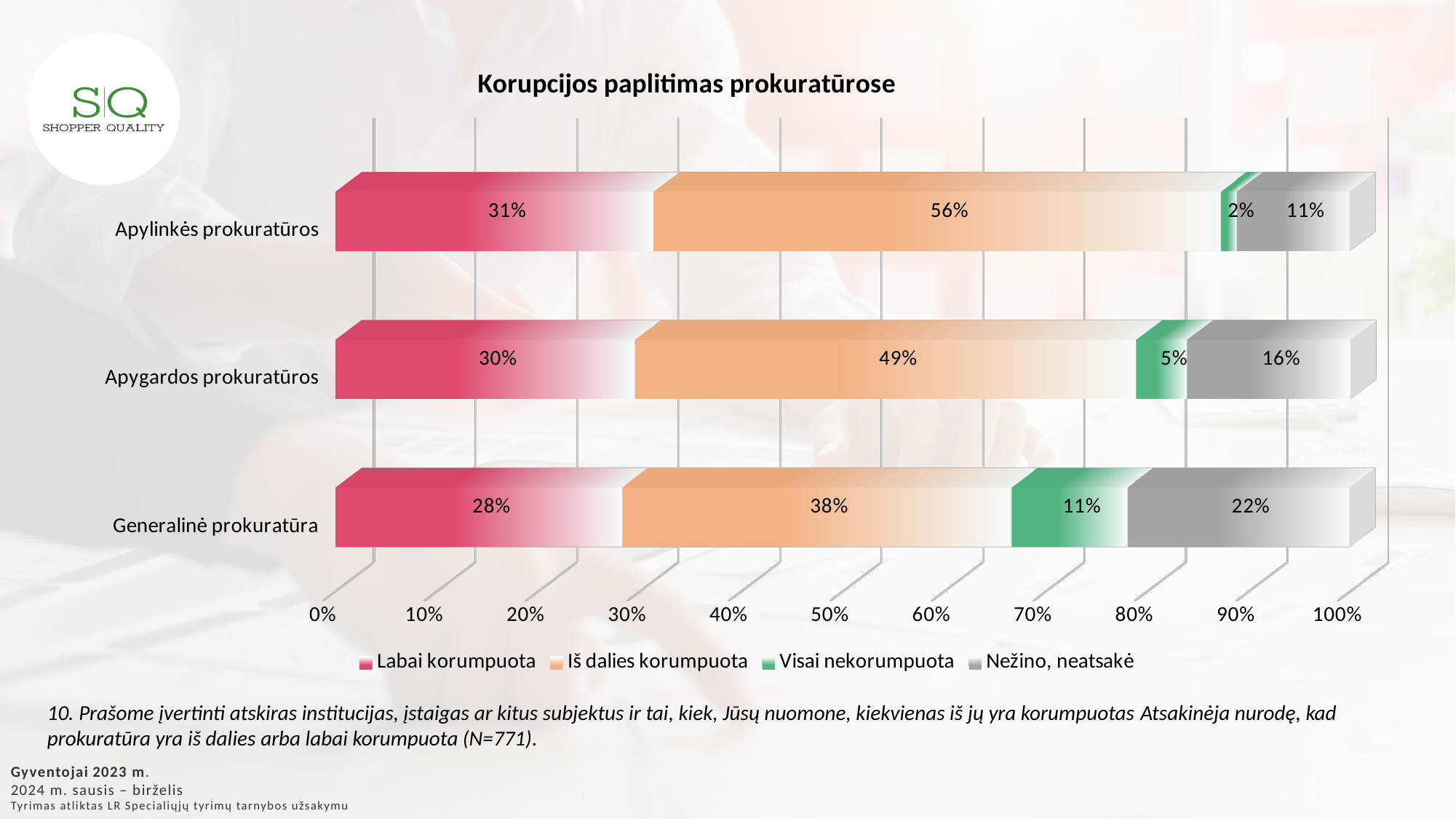
How many series does the legend list? 4 What is the 'Iš dalies korumpuota' value for Apylinkės prokuratūros? 56% How many categories (institutions) are plotted on the chart? 3 Which category has the lowest 'Visai nekorumpuota' value? Apylinkės prokuratūros Which category has the highest 'Labai korumpuota' value? Apylinkės prokuratūros What is the combined share of 'Labai korumpuota' and 'Iš dalies korumpuota' for Generalinė prokuratūra? 66% What is the 'Visai nekorumpuota' value for Apygardos prokuratūros? 5% What is the 'Nežino, neatsakė' value for Generalinė prokuratūra? 22% What kind of chart is shown on the slide? Stacked bar chart Which is larger: the 'Nežino, neatsakė' value for Apygardos prokuratūros or for Apylinkės prokuratūros? Apygardos prokuratūros What is the title of the chart? Korupcijos paplitimas prokuratūrose What is the difference between the 'Iš dalies korumpuota' values for Apylinkės prokuratūros and Generalinė prokuratūra? 18%